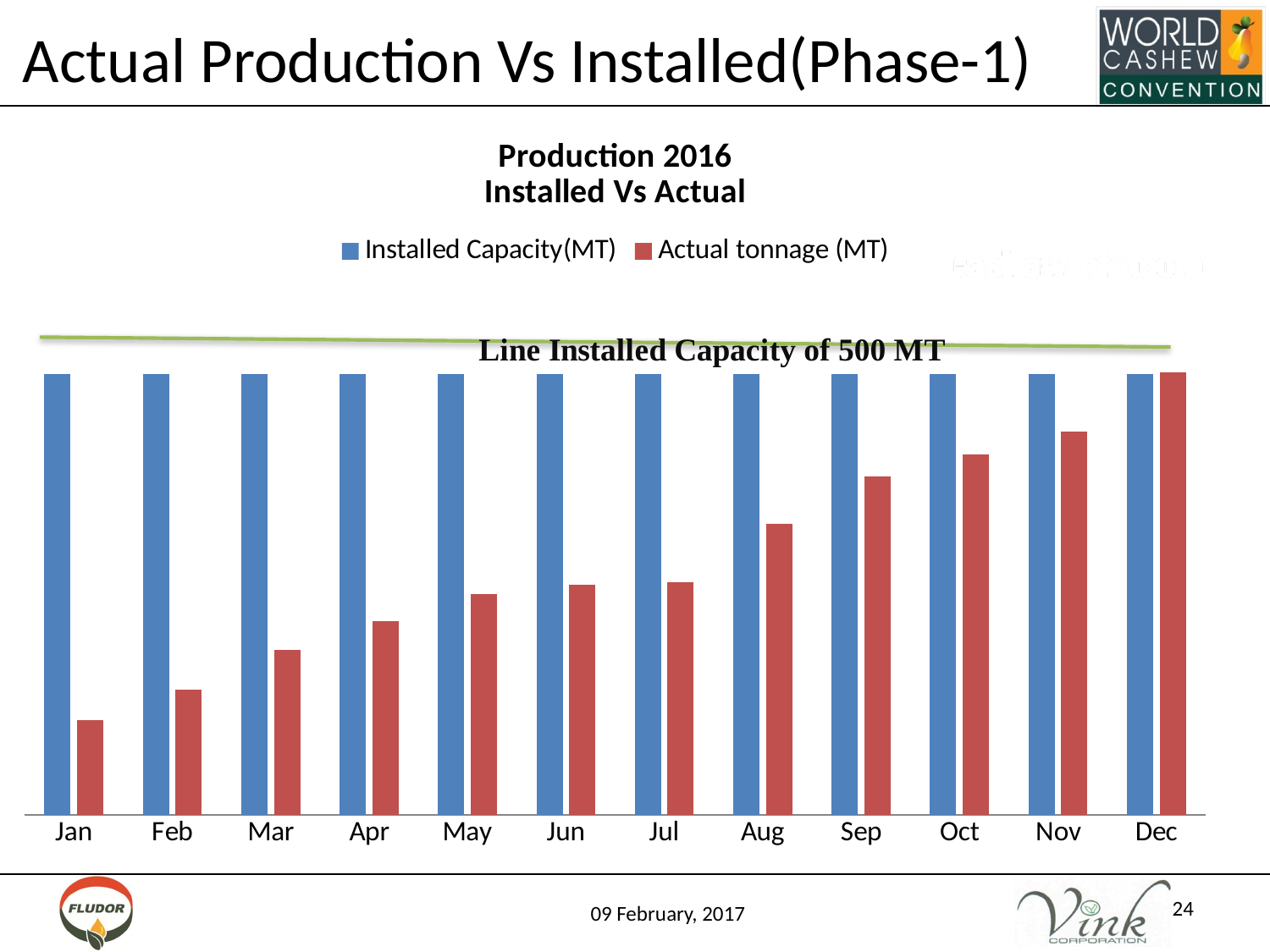
Which is larger, the Actual tonnage (MT) in Mar or in Nov? Nov What is the title of the chart? Production 2016 Installed Vs Actual How many series does the chart legend list? 2 How many months are shown along the x axis of the chart? 12 Which is larger, the Actual tonnage (MT) in Aug or in Jun? Aug Does the Actual tonnage (MT) generally rise or fall from Jan to Dec? Rise Which month has the highest Actual tonnage (MT)? Dec What kind of chart is shown on the slide? Bar chart Which is larger, the Actual tonnage (MT) in Jan or the Installed Capacity(MT) in Jan? Installed Capacity(MT) Which month has the lowest Actual tonnage (MT)? Jan Which series is shown in red in the chart? Actual tonnage (MT)